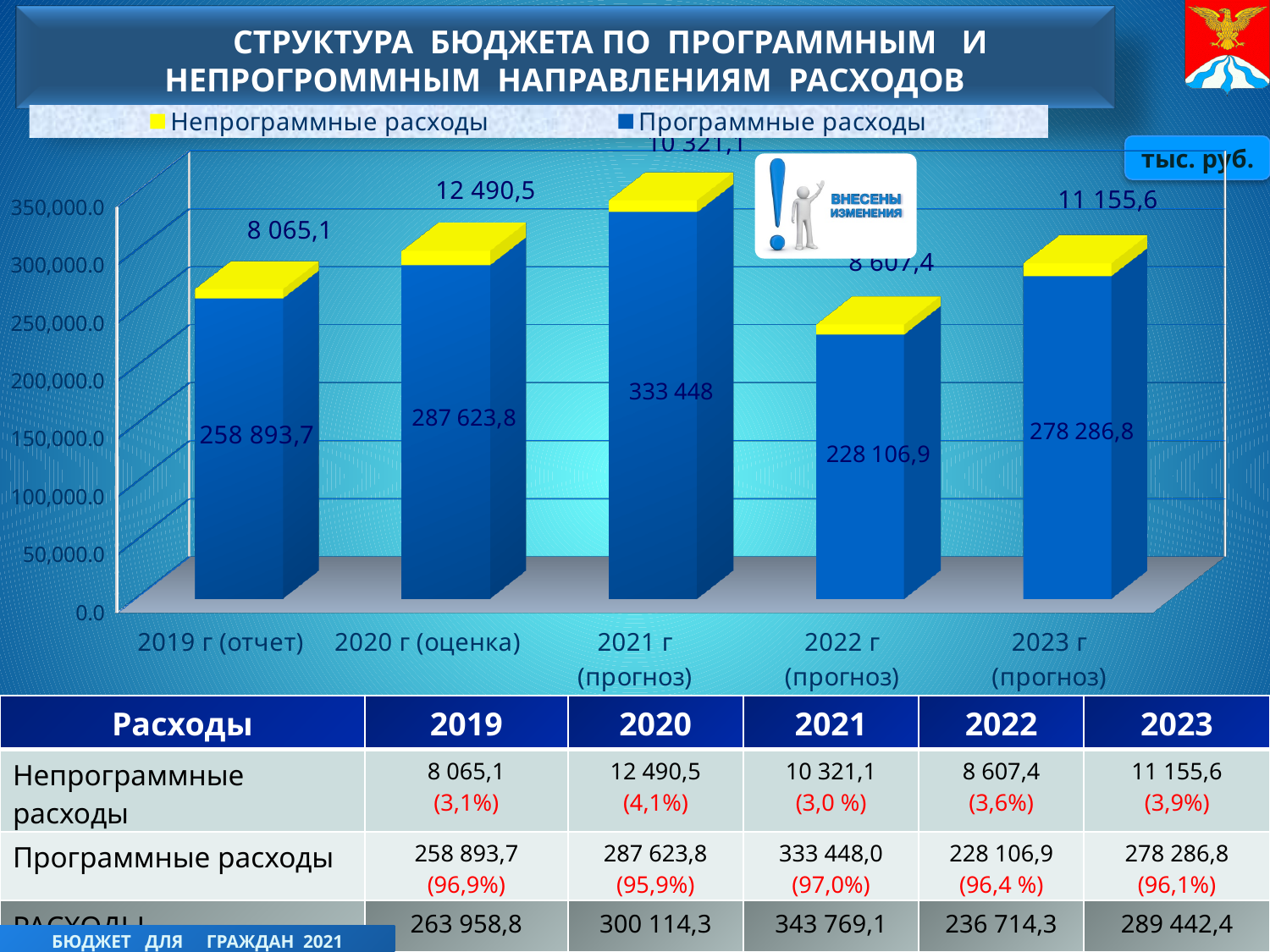
Which year has the lowest value of Программные расходы? 2022 г (прогноз) How many series does the chart legend list? 2 What is the total of the stacked bar for 2023 г (прогноз)? 289 442,4 Which is larger: Непрограммные расходы in 2020 г (оценка) or in 2023 г (прогноз)? 2020 г (оценка) Which year has the highest value of Программные расходы? 2021 г (прогноз) What is the value of Программные расходы for 2019 г (отчет)? 258 893,7 How many categories (years) are shown on the x axis of the chart? 5 What is the value of Программные расходы for 2021 г (прогноз)? 333 448 Which colour represents Непрограммные расходы in the chart? yellow What is the difference between Программные расходы in 2021 г (прогноз) and 2022 г (прогноз)? 105 341,1 What type of chart is shown on the slide? bar chart What is the value of Непрограммные расходы for 2023 г (прогноз)? 11 155,6